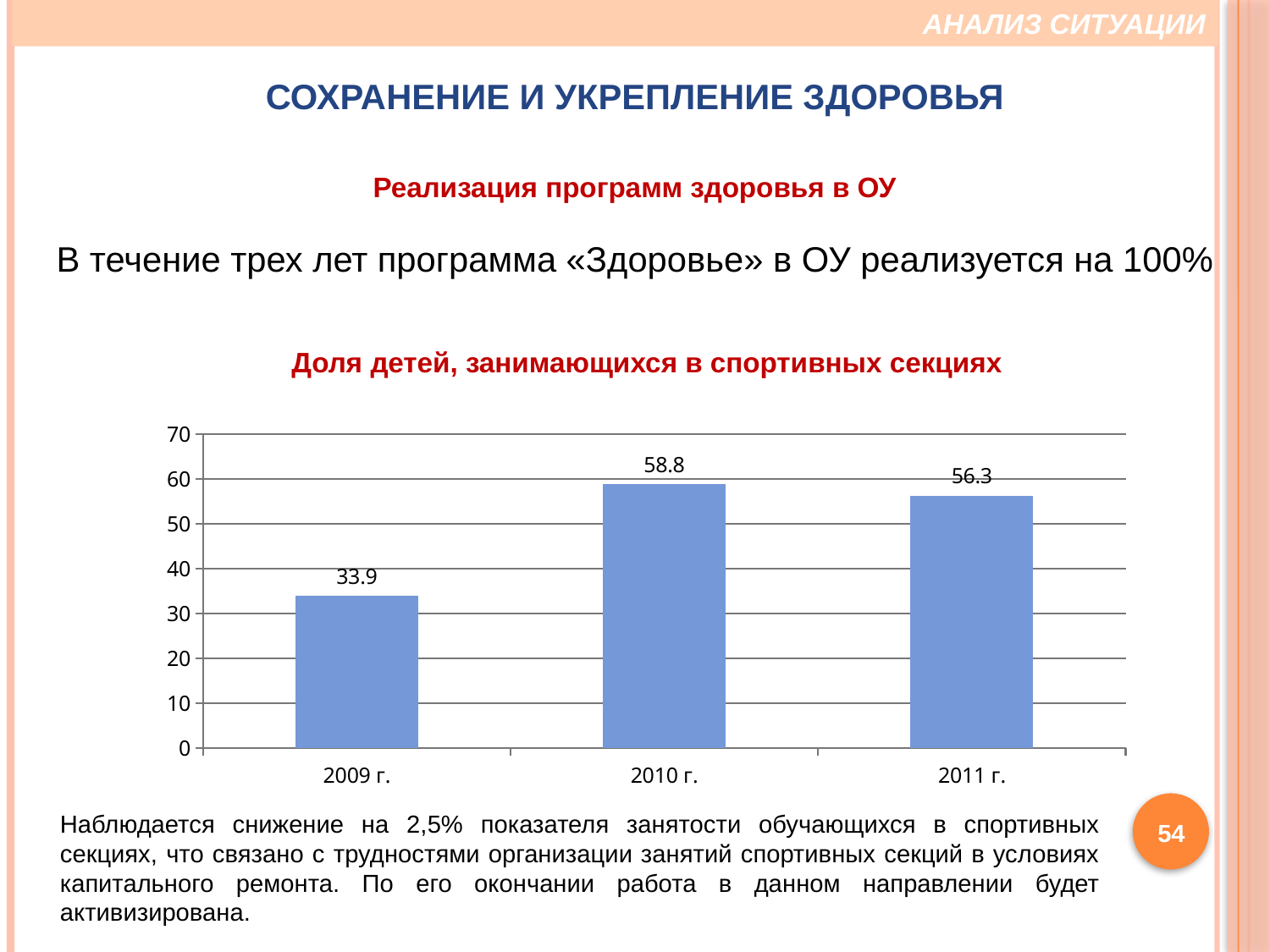
What is the title of the chart? Доля детей, занимающихся в спортивных секциях What kind of chart is shown on the slide? bar chart Which year has the lowest value? 2009 г. How many years are shown on the x axis? 3 Is the value for 2009 г. greater or less than 40? less Which year has the highest value? 2010 г. What is the difference between the values for 2010 г. and 2009 г.? 24.9 Which is larger, the value for 2009 г. or the value for 2011 г.? 2011 г. What is the difference between the values for 2010 г. and 2011 г.? 2.5 What is the value for 2009 г.? 33.9 What is the value for 2011 г.? 56.3 What is the value for 2010 г.? 58.8